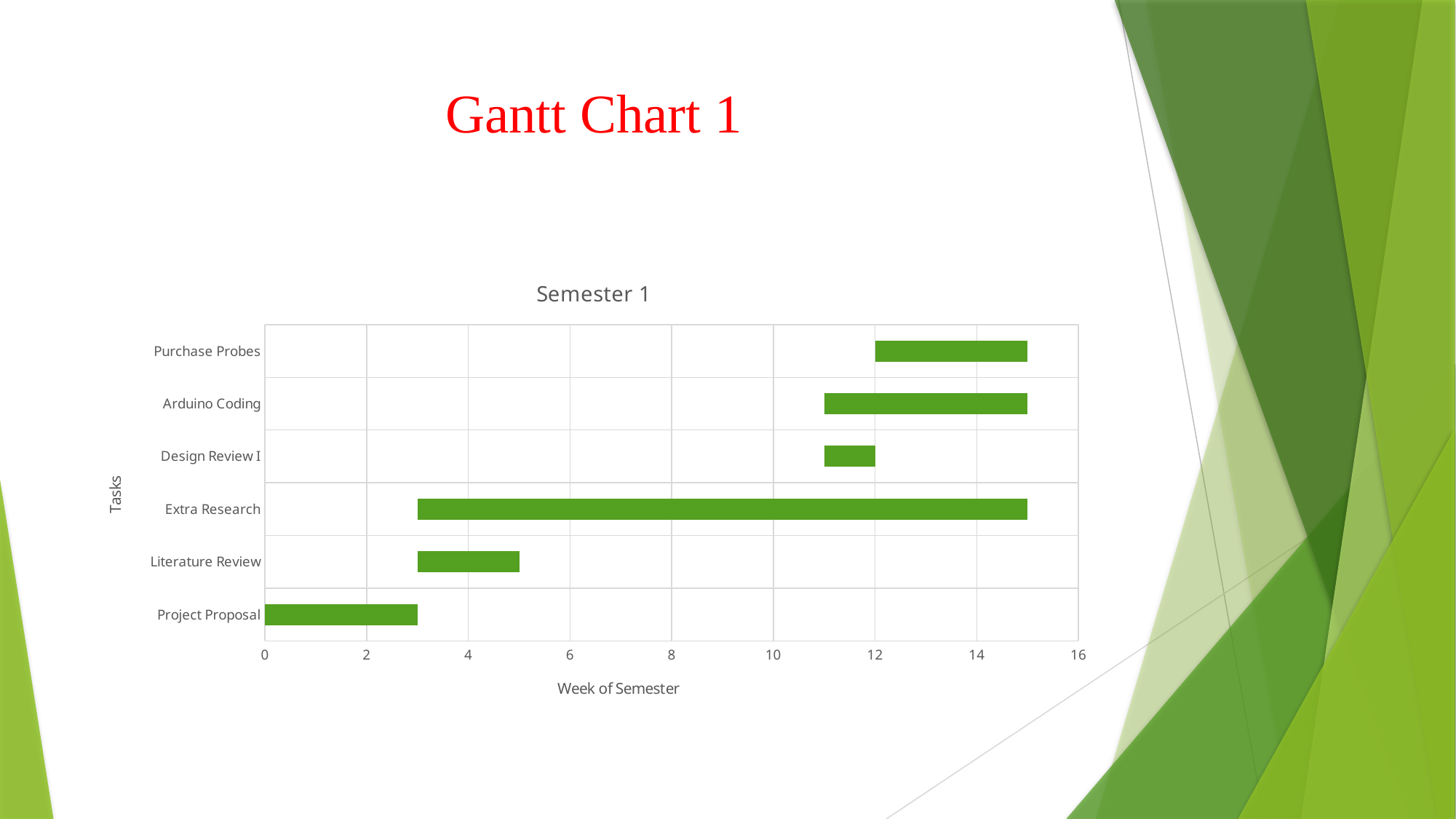
Is the week at which the Literature Review bar ends greater or less than 6? less Which task has the shortest bar? Design Review I What is the title of the chart? Semester 1 At which week does the Purchase Probes bar start? 12 How many tasks are listed on the vertical axis? 6 What is the label of the horizontal axis? Week of Semester Is the week at which the Extra Research bar ends greater or less than 14? greater What type of chart is shown on the slide? Bar chart (Gantt chart) At which week does the Project Proposal bar start? 0 Which bar is longer, Arduino Coding or Purchase Probes? Arduino Coding Which task has the longest bar? Extra Research At which week does the Design Review I bar end? 12